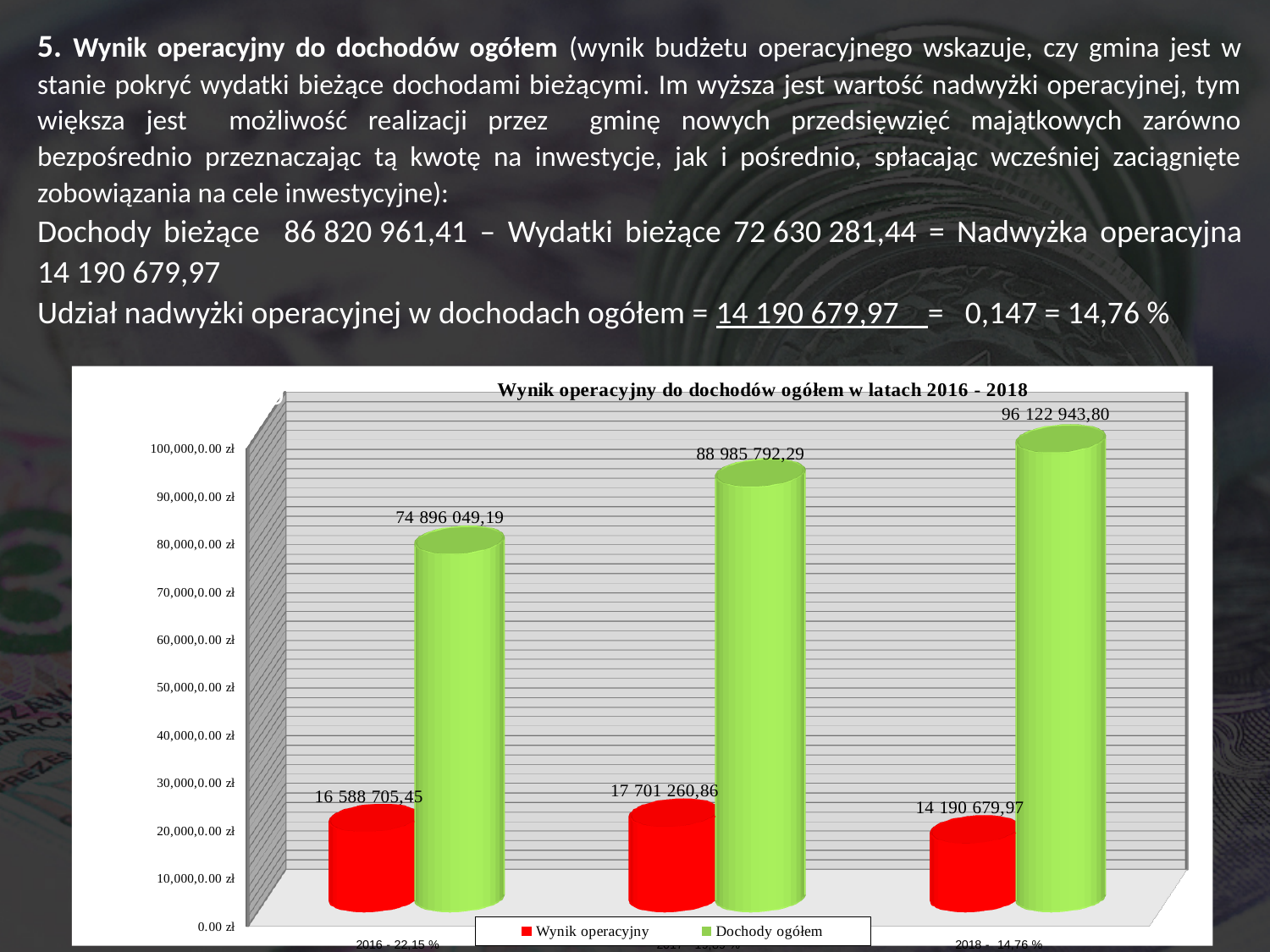
What is the value of Dochody ogółem for 2018? 96 122 943,80 How many series does the legend list? 2 What is the difference between Dochody ogółem in 2018 and in 2016? 21 226 894,61 What kind of chart is shown on the slide? bar chart In which year is Dochody ogółem highest? 2018 What is the value of Dochody ogółem for 2016? 74 896 049,19 Is the value of Dochody ogółem for 2018 greater or less than 90,000,0.00 zł? greater Which is larger: Wynik operacyjny in 2016 or Wynik operacyjny in 2018? Wynik operacyjny in 2016 In which year is Wynik operacyjny lowest? 2018 What is the value of Wynik operacyjny for 2016? 16 588 705,45 What is the value of Wynik operacyjny for 2018? 14 190 679,97 Does Dochody ogółem rise or fall from 2016 to 2018? rise